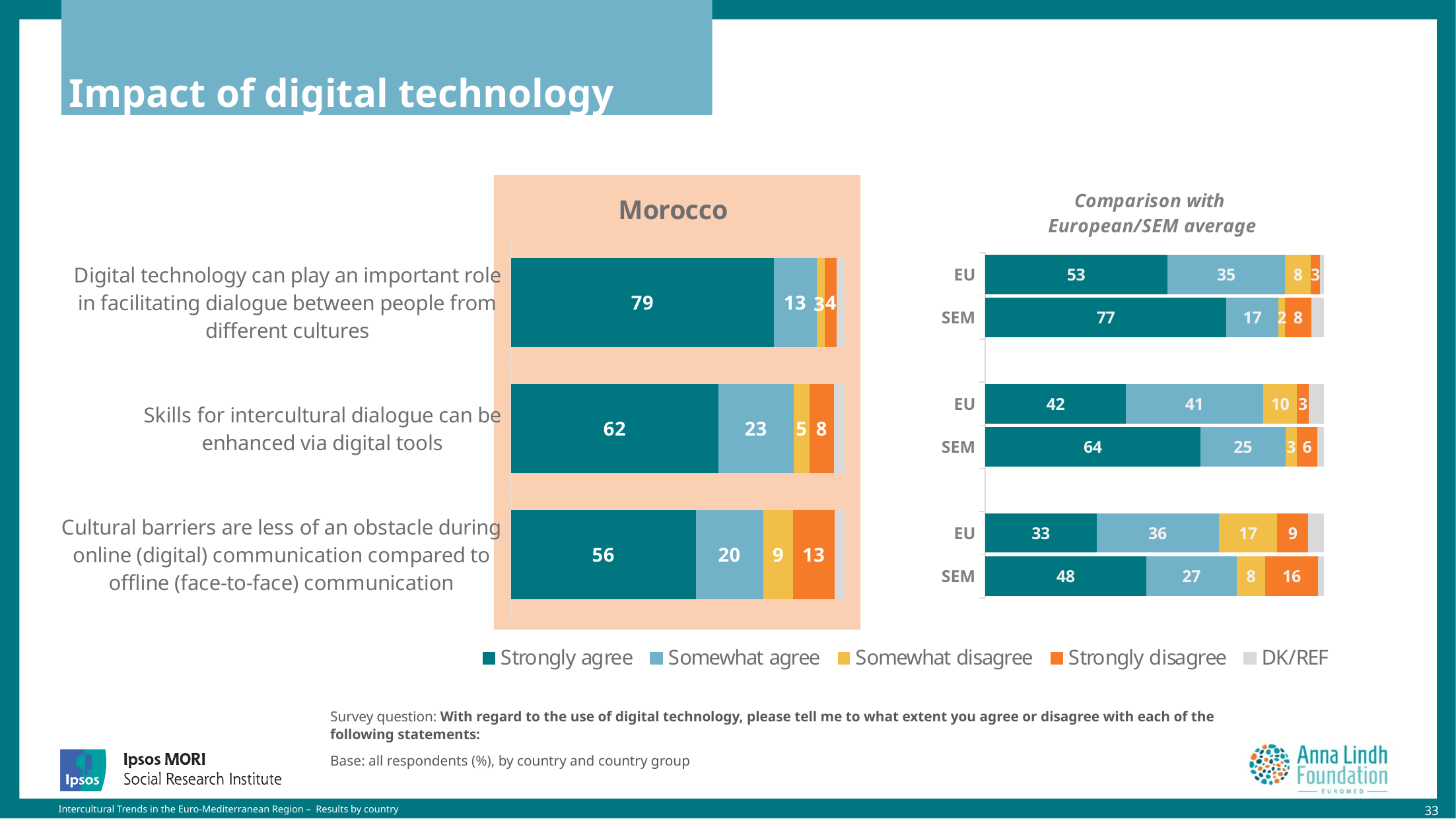
How many series does the legend list for the charts on this slide? 5 In the Morocco chart, which statement has the larger 'Somewhat agree' value: skills enhanced via digital tools, or cultural barriers less of an obstacle online? Skills for intercultural dialogue can be enhanced via digital tools In the Morocco chart, what percentage strongly disagree that cultural barriers are less of an obstacle during online communication compared to offline communication? 13 How many statements are shown in the Morocco chart? 3 In the Comparison with European/SEM average chart, what is the SEM 'Strongly agree' value for the top pair of bars (digital technology can play an important role in facilitating dialogue)? 77 In the Morocco chart, what is the difference between the 'Strongly agree' values for the digital technology dialogue statement and the cultural barriers statement? 23 In the Morocco chart, which statement has the highest 'Strongly agree' value? Digital technology can play an important role in facilitating dialogue between people from different cultures In the Comparison with European/SEM average chart, what is the EU 'Somewhat disagree' value for the bottom pair of bars (cultural barriers are less of an obstacle online)? 17 In the Morocco chart, what percentage strongly agree that skills for intercultural dialogue can be enhanced via digital tools? 62 What is the title of the chart on the right side of the slide? Comparison with European/SEM average What kind of chart is the Morocco chart? Stacked bar chart In the Comparison with European/SEM average chart, what is the difference between the SEM and EU 'Strongly agree' values for the top pair of bars? 24